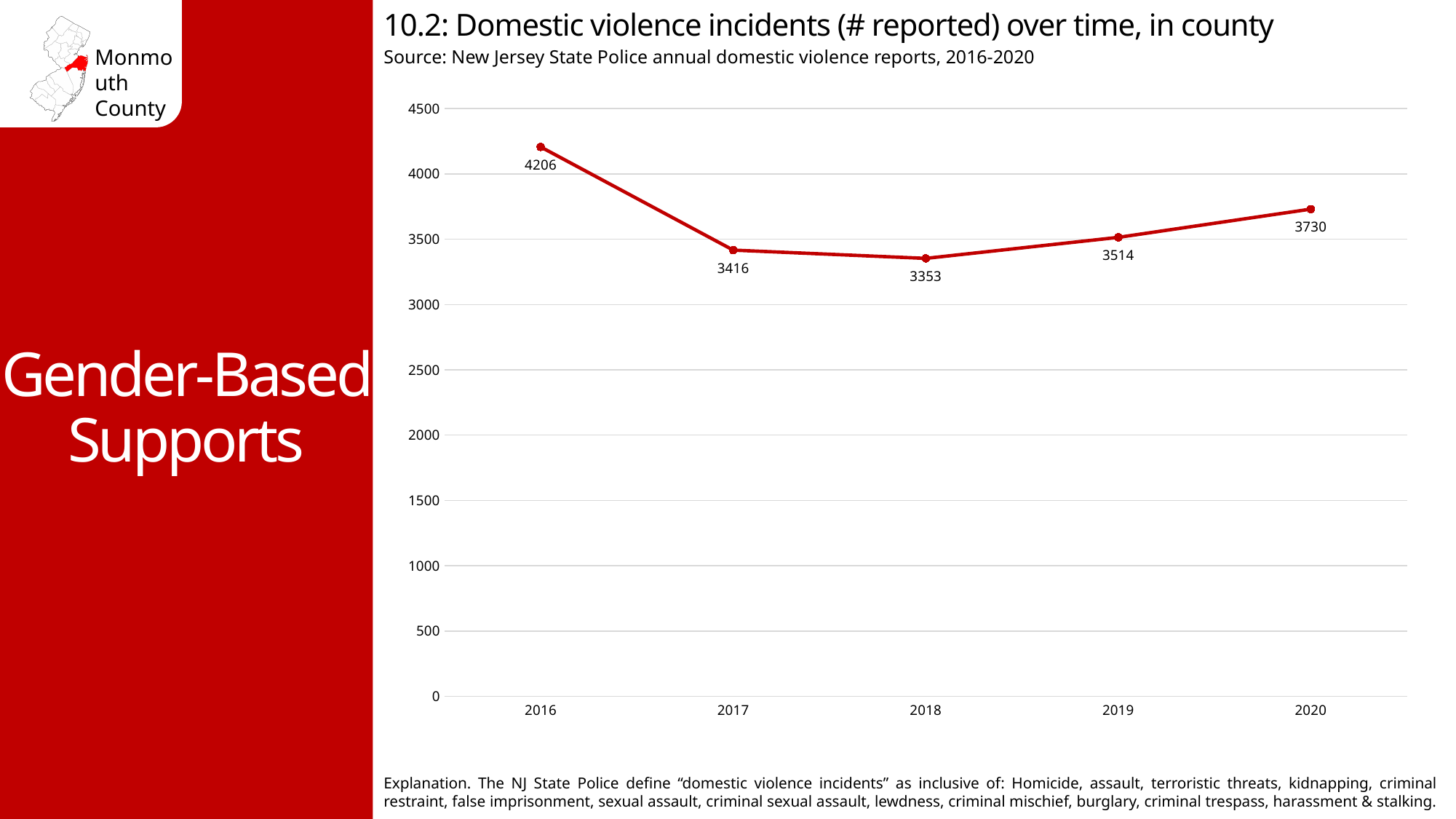
Is the value for 2018 greater or less than 3500? less Which year has the highest number of reported domestic violence incidents? 2016 Which year has the lowest number of reported domestic violence incidents? 2018 What kind of chart is shown on the slide? line chart What is the value plotted for 2020? 3730 By how much did the number of incidents increase from 2019 to 2020? 216 What is the value plotted for 2018? 3353 Do the values rise or fall from 2018 to 2020? rise How many years are plotted on the x axis? 5 What is the difference between the 2016 value and the 2017 value? 790 Which year has a larger value, 2017 or 2019? 2019 How many domestic violence incidents were reported in 2016? 4206